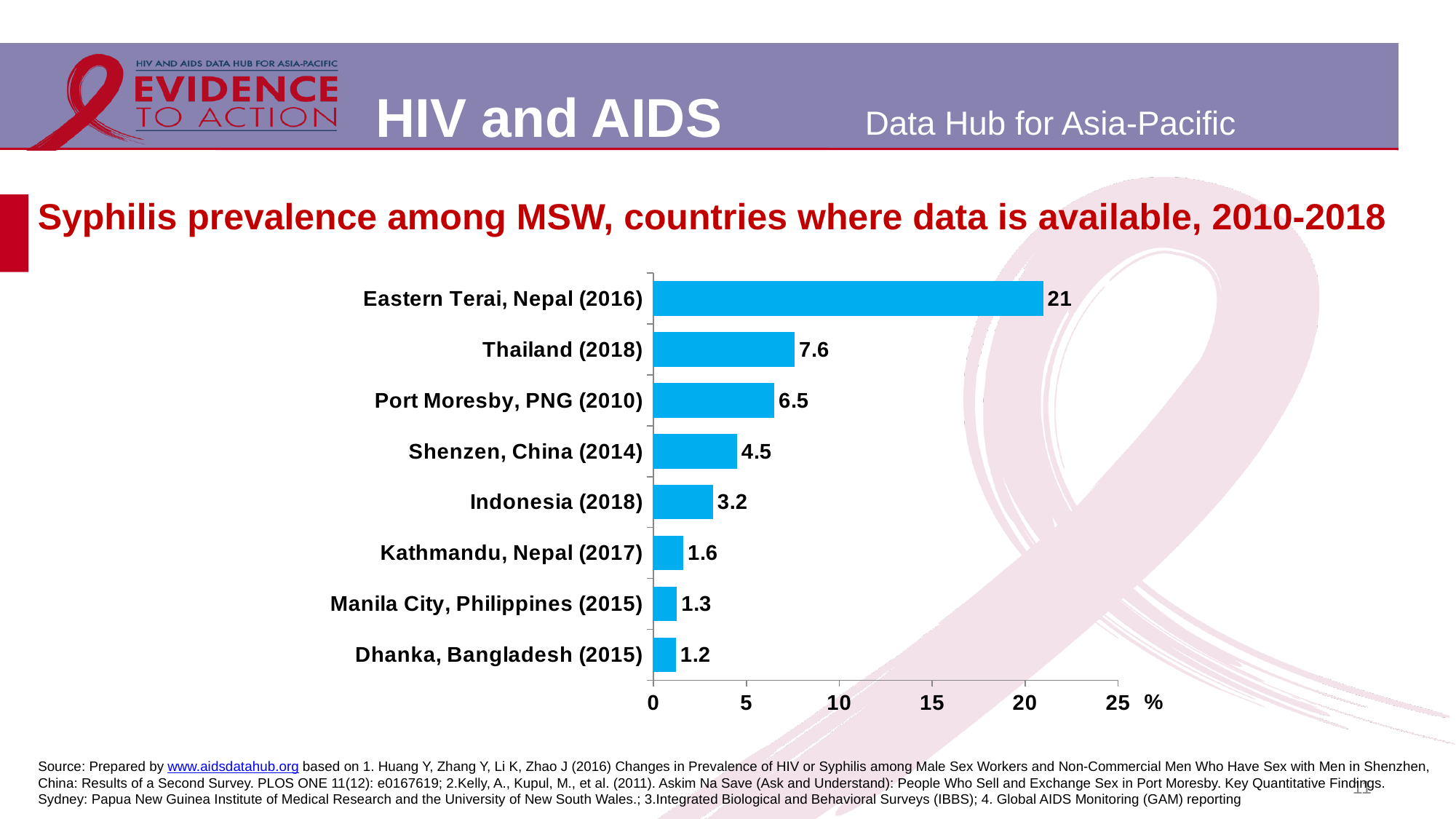
What is the value shown for Thailand (2018)? 7.6 What is the difference between the values for Eastern Terai, Nepal (2016) and Indonesia (2018)? 17.8 Which category has the highest syphilis prevalence on the chart? Eastern Terai, Nepal (2016) What is the value shown for Shenzen, China (2014)? 4.5 What kind of chart is shown on the slide? Bar chart What is the syphilis prevalence value shown for Eastern Terai, Nepal (2016)? 21 Is the value for Eastern Terai, Nepal (2016) greater or less than 20? greater Which is larger, the value for Indonesia (2018) or the value for Shenzen, China (2014)? Shenzen, China (2014) Which category has the lowest syphilis prevalence on the chart? Dhanka, Bangladesh (2015) How many categories are shown on the chart? 8 What is the difference between the values for Thailand (2018) and Port Moresby, PNG (2010)? 1.1 What is the value shown for Kathmandu, Nepal (2017)? 1.6